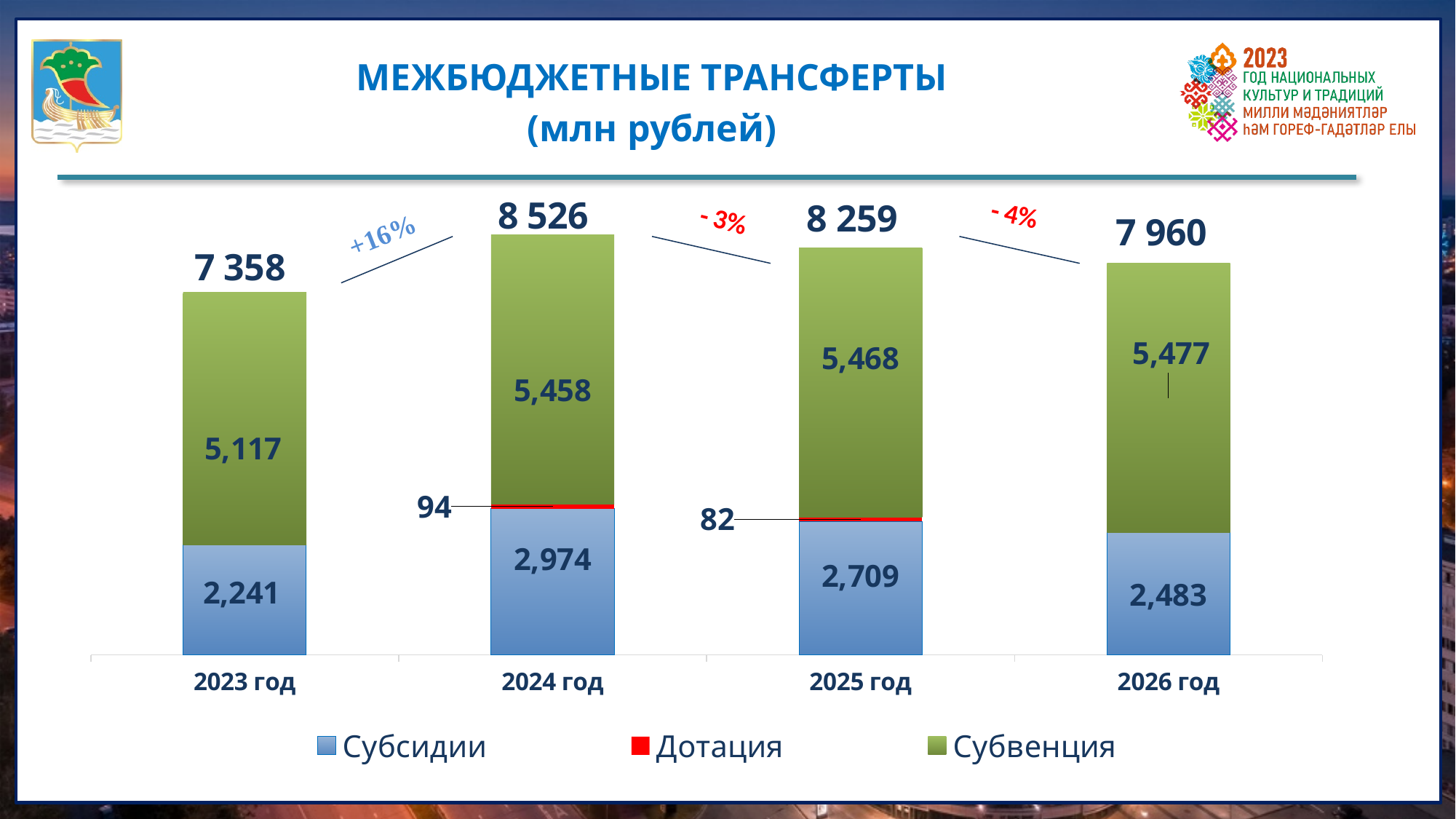
What percentage change is shown between 2023 год and 2024 год? +16% What is the value of Дотация for 2025 год? 82 How many series does the legend list? 3 Which is larger: Субвенция for 2025 год or Субвенция for 2024 год? Субвенция for 2025 год What is the value of Субвенция for 2023 год? 5,117 Which year has the highest total of intergovernmental transfers? 2024 год What is the value of Субсидии for 2024 год? 2,974 What is the total of the stacked bar for 2026 год? 7 960 What is the difference between the Субсидии values for 2024 год and 2025 год? 265 How many years are shown on the x axis? 4 What kind of chart is shown on the slide? Stacked bar chart Which year has the lowest value of Субсидии? 2023 год